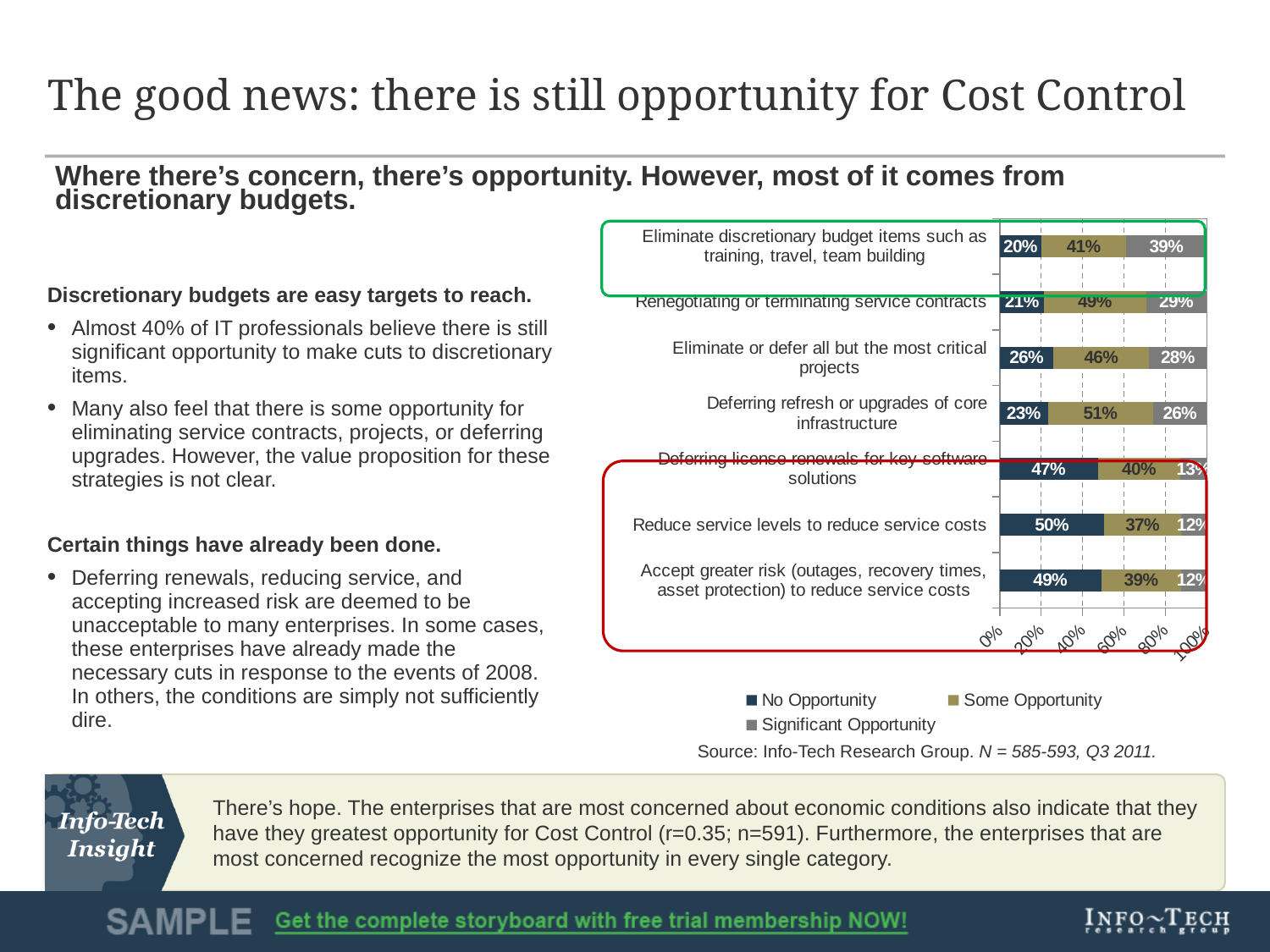
Which category has the lowest No Opportunity value? Eliminate discretionary budget items such as training, travel, team building Which category has the highest No Opportunity value? Reduce service levels to reduce service costs What is the Some Opportunity value for 'Deferring refresh or upgrades of core infrastructure'? 51% What is the Significant Opportunity value for 'Eliminate discretionary budget items such as training, travel, team building'? 39% Which legend entry is shown in dark blue? No Opportunity What is the difference between the Some Opportunity values for 'Renegotiating or terminating service contracts' and 'Eliminate or defer all but the most critical projects'? 3% How many series does the chart legend list? 3 Which has a larger Significant Opportunity value: 'Eliminate or defer all but the most critical projects' or 'Accept greater risk (outages, recovery times, asset protection) to reduce service costs'? Eliminate or defer all but the most critical projects How many categories (cost control strategies) are plotted in the chart? 7 What type of chart is shown on the slide? stacked bar chart What is the No Opportunity value for 'Reduce service levels to reduce service costs'? 50% What is the total of the stacked bar for 'Renegotiating or terminating service contracts'? 99%